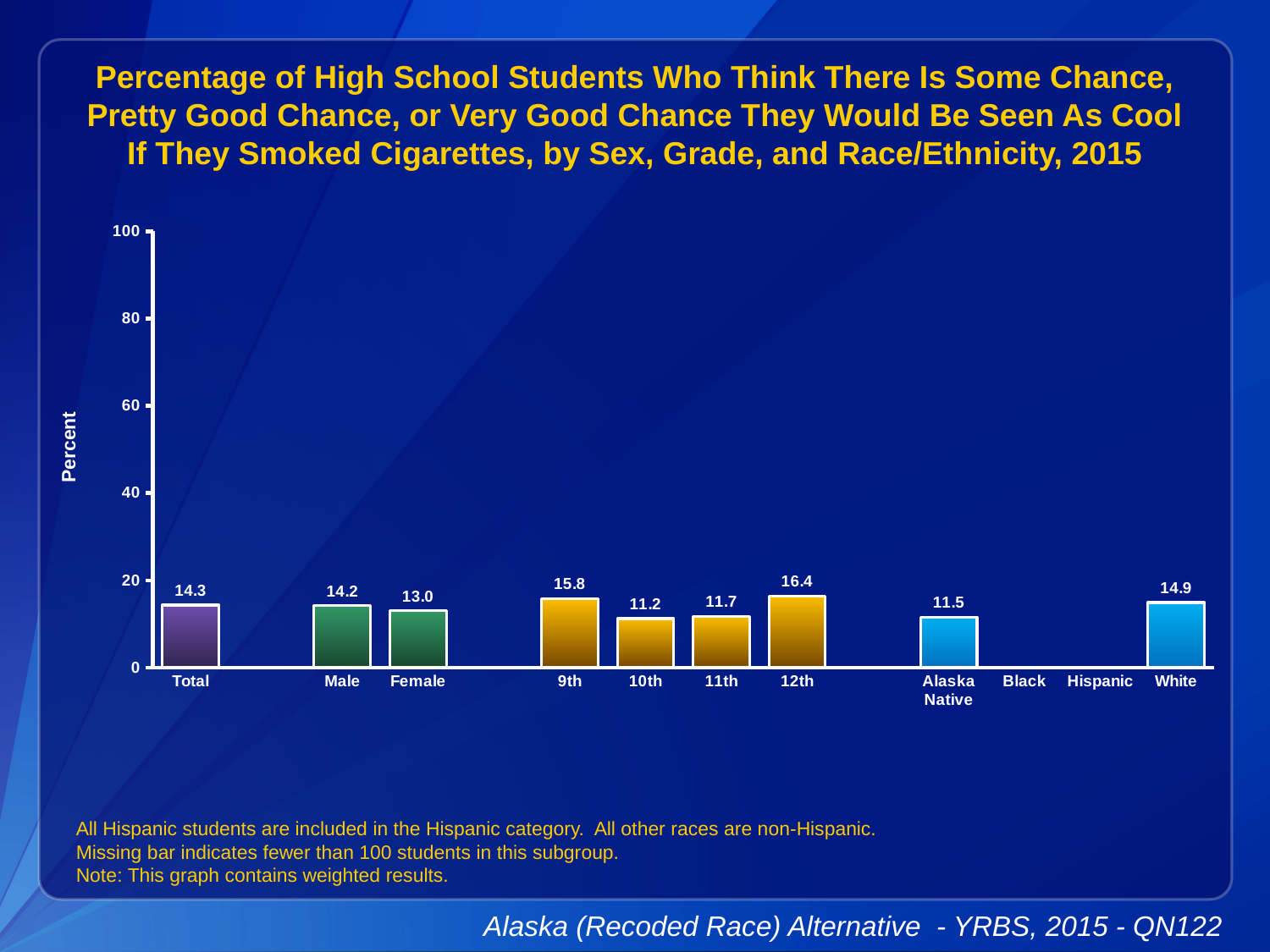
What is the value for 12th grade? 16.4 What kind of chart is shown on the slide? bar chart What is the difference between the 12th and 10th grade values? 5.2 Is the value for 9th grade greater or less than 20? less How many bars are plotted on the chart? 9 Which grade has the highest value? 12th What is the value for Total? 14.3 Which is larger, the value for White or the value for Alaska Native? White What is the difference between the Male and Female values? 1.2 What is the value for Alaska Native? 11.5 Which grade has the lowest value? 10th What is the value for Female? 13.0